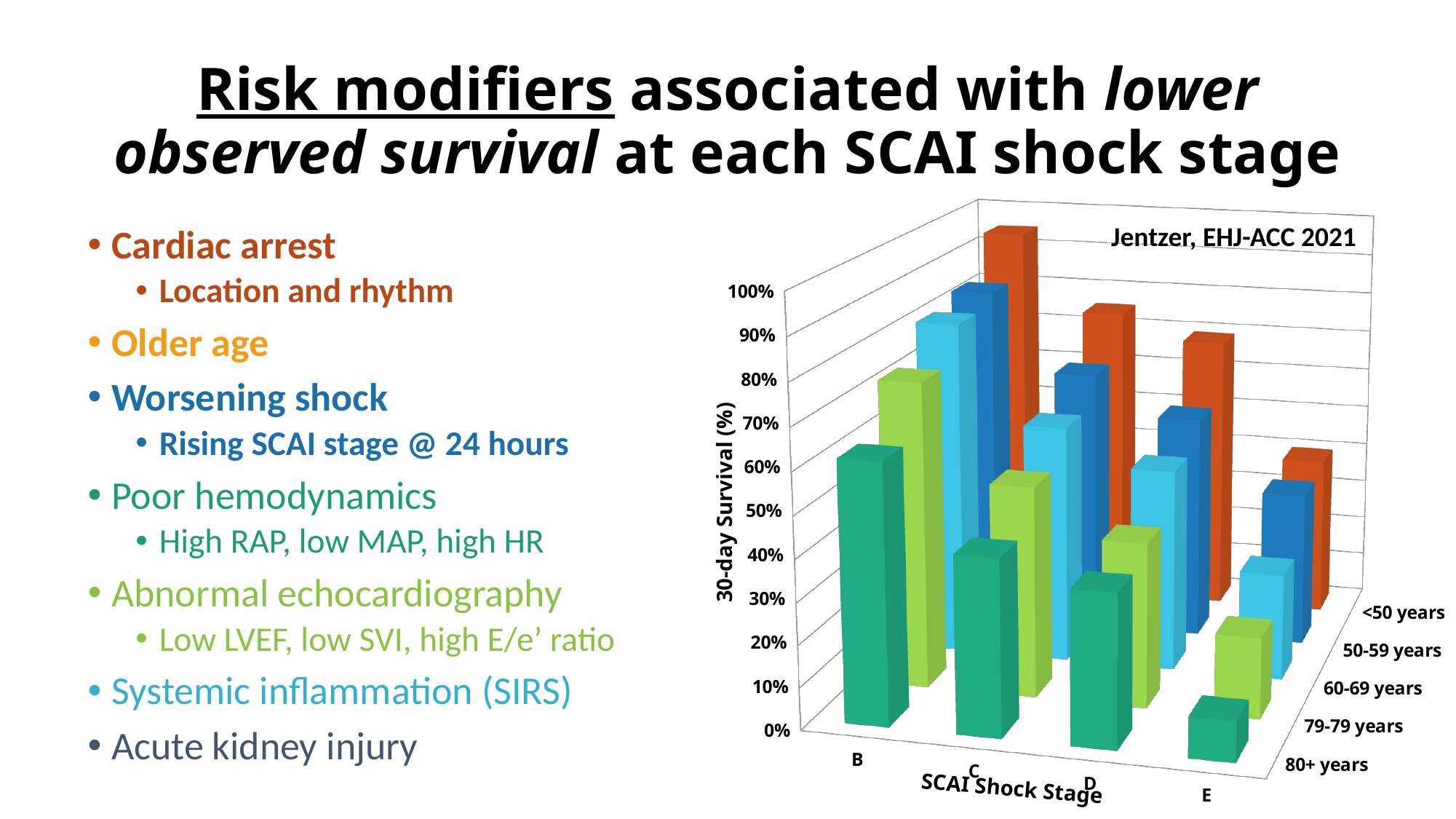
Within the 80+ years group, which SCAI shock stage has the highest 30-day survival? B What citation is printed on the chart? Jentzer, EHJ-ACC 2021 What is the title of the vertical axis of the chart? 30-day Survival (%) Is the 30-day survival for the 80+ years group at SCAI shock stage B greater or less than 40%? greater Is the 30-day survival for the 80+ years group at SCAI shock stage E greater or less than 20%? less Within the 80+ years group, which SCAI shock stage has the lowest 30-day survival? E For the 80+ years group, does 30-day survival rise or fall as the SCAI shock stage goes from B to E? fall What kind of chart is shown on the slide? bar chart How many SCAI shock stages are shown along the x axis of the chart? 4 At SCAI shock stage E, which age group has the highest 30-day survival? <50 years At SCAI shock stage E, which is larger: 30-day survival for <50 years or for 80+ years? <50 years How many age groups are plotted in the chart? 5